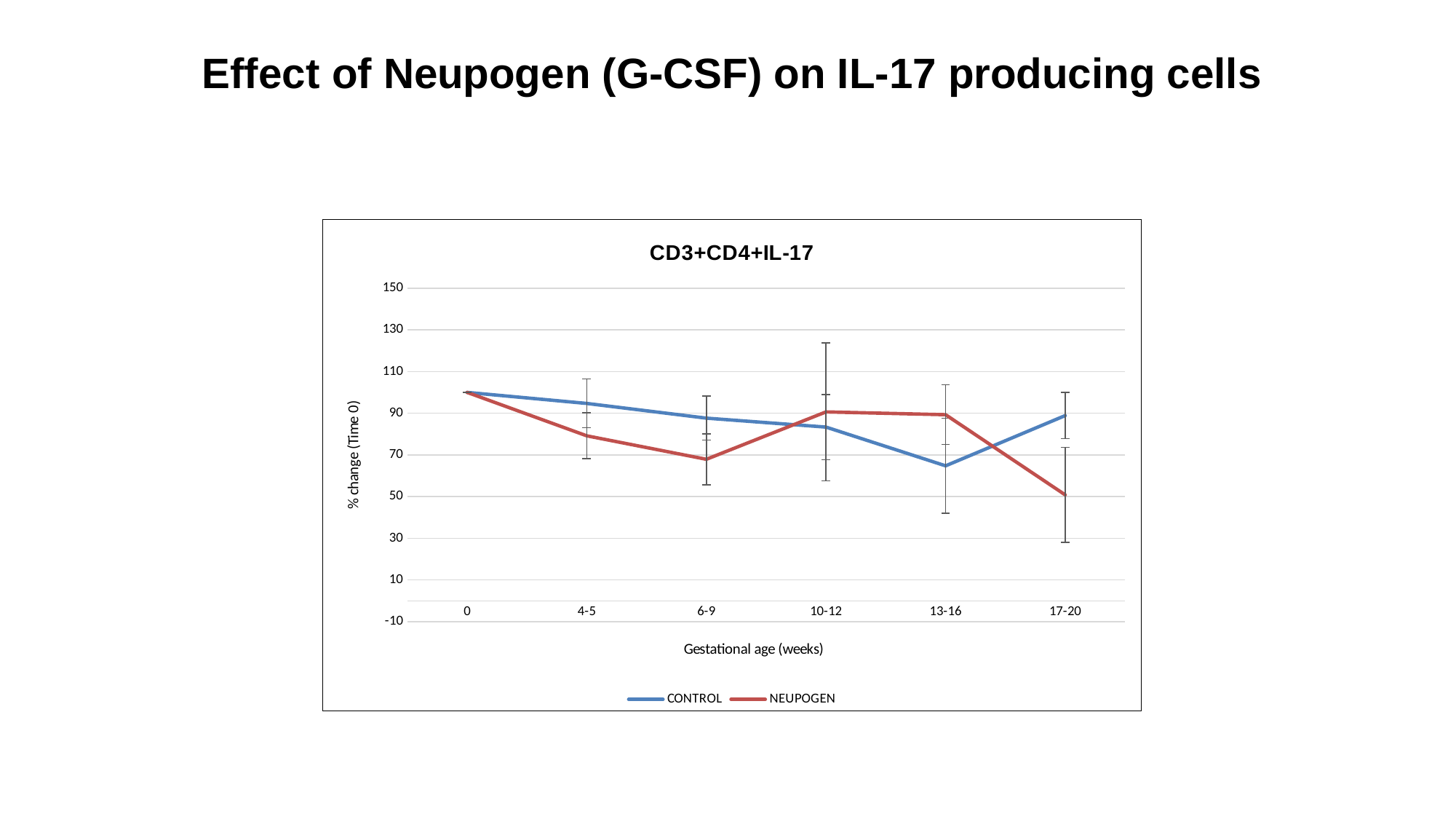
What is the label of the x axis? Gestational age (weeks) At 13-16 weeks, which series has the larger value, CONTROL or NEUPOGEN? NEUPOGEN At which gestational age is the CONTROL value lowest? 13-16 How many gestational age categories are plotted along the x axis? 6 At which gestational age is the NEUPOGEN value lowest? 17-20 Is the NEUPOGEN value at 17-20 weeks greater or less than 70? less What is the title of the chart? CD3+CD4+IL-17 How many series does the legend list? 2 What kind of chart is shown on the slide? line chart At 17-20 weeks, which series has the larger value, CONTROL or NEUPOGEN? CONTROL Is the NEUPOGEN value at 10-12 weeks greater or less than 70? greater At 4-5 weeks, which series has the larger value, CONTROL or NEUPOGEN? CONTROL